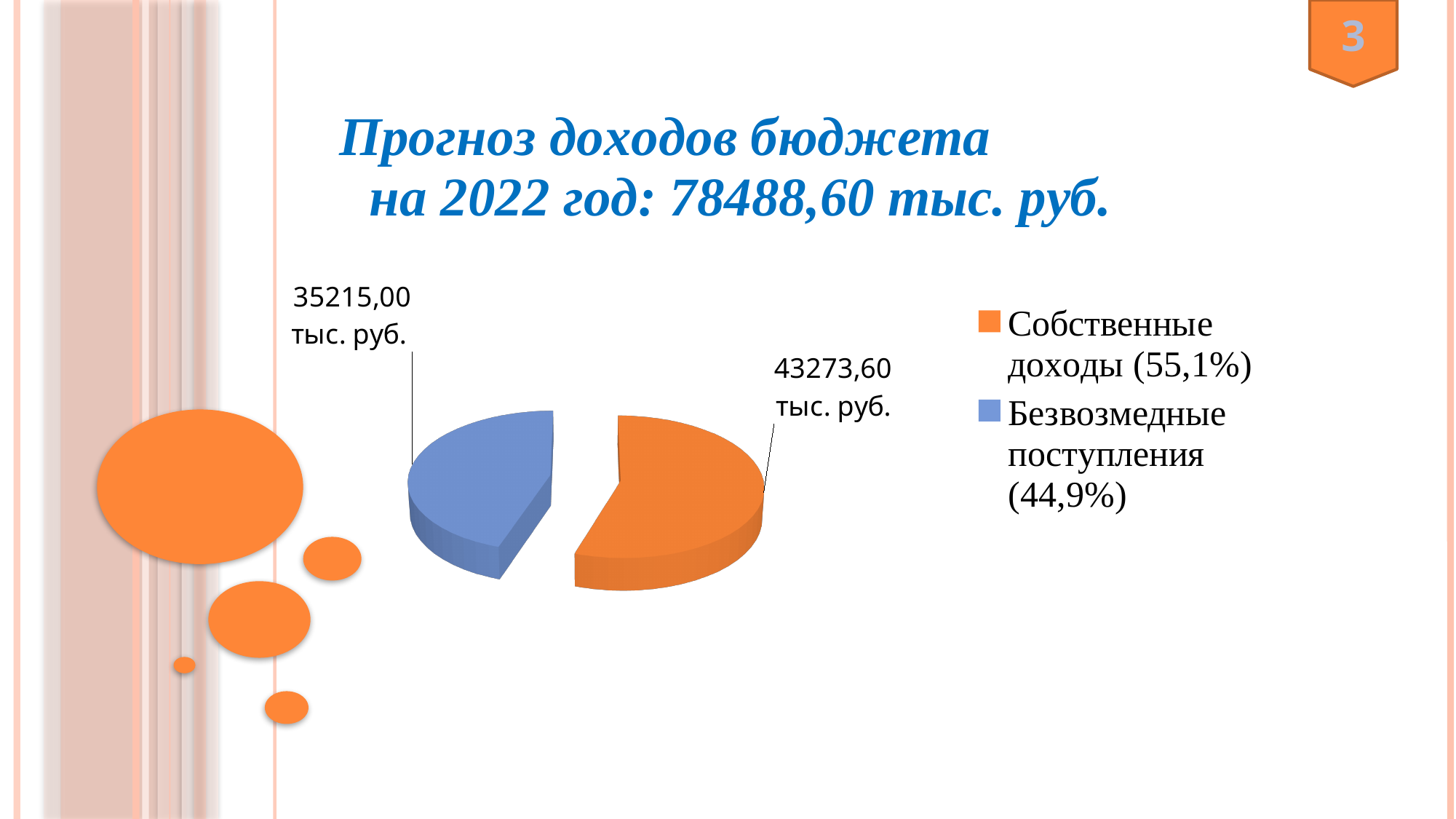
What kind of chart is shown on the slide? Pie chart What is the total budget income forecast for 2022 stated in the slide title? 78488,60 тыс. руб. What is the difference between the values for Собственные доходы and Безвозмедные поступления? 8058,60 тыс. руб. What is the value for Собственные доходы? 43273,60 тыс. руб. Which category has the largest slice of the pie? Собственные доходы What is the value for Безвозмедные поступления? 35215,00 тыс. руб. Which is larger, Собственные доходы or Безвозмедные поступления? Собственные доходы How many slices does the pie chart have? 2 Which category has the smallest slice of the pie? Безвозмедные поступления What colour is the slice for Безвозмедные поступления? Blue What share of the pie does Собственные доходы represent? 55,1% What share of the pie does Безвозмедные поступления represent? 44,9%